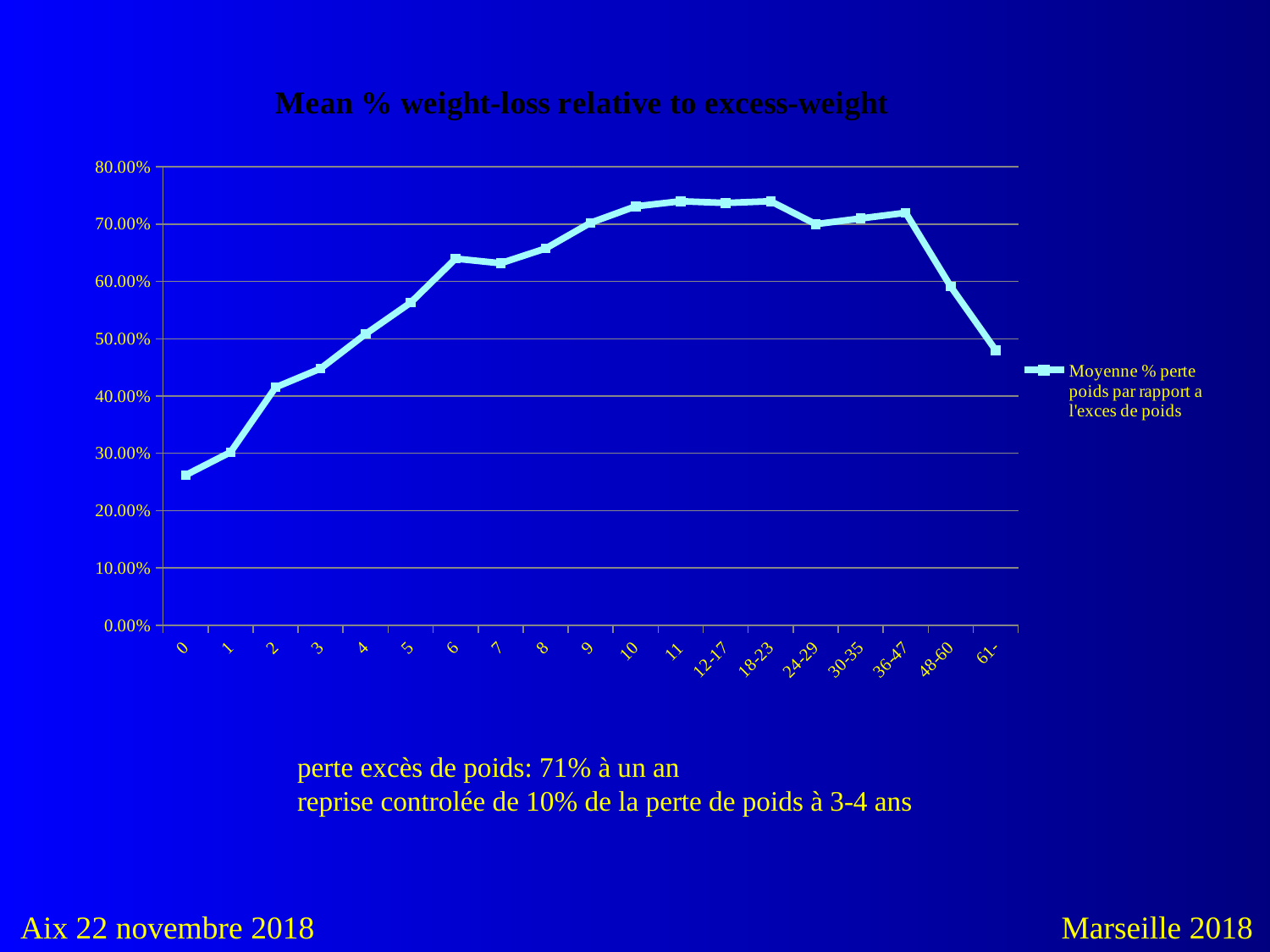
How many series does the legend list? 1 Is the value for category 6 greater or less than 60.00%? greater Do the values rise or fall from category 36-47 to category 61-? fall Is the value for category 11 greater or less than 70.00%? greater Do the values rise or fall from category 0 to category 11? rise How many categories are shown along the x axis? 19 Which category has the lowest value? 0 Is the value for category 0 greater or less than 30.00%? less Which is larger, the value for category 0 or the value for category 61-? 61- What is the title of the chart? Mean % weight-loss relative to excess-weight What kind of chart is shown on the slide? line chart